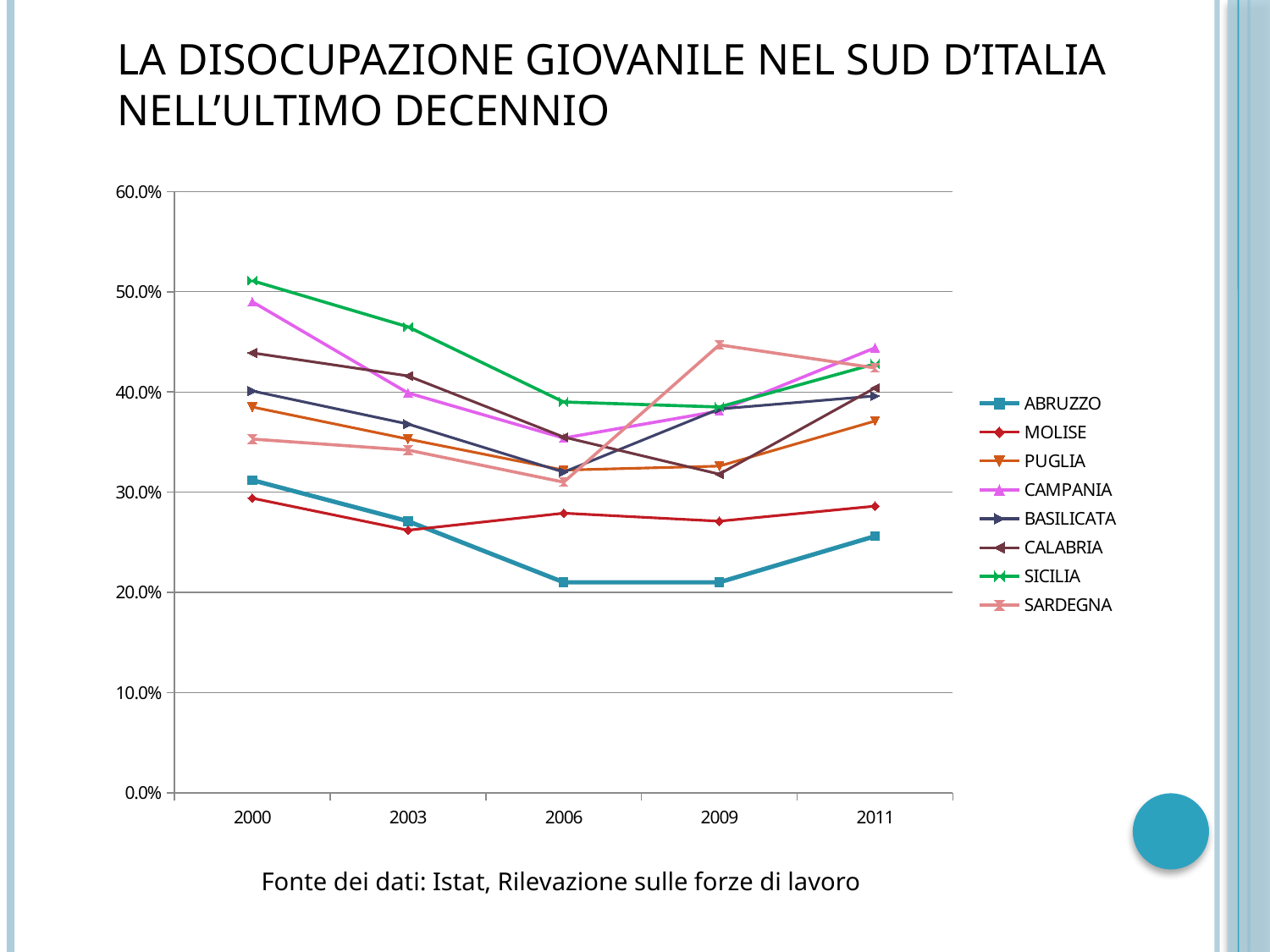
Which region has the lowest value in 2006? ABRUZZO What data source is cited below the chart? Istat, Rilevazione sulle forze di lavoro Is the value for CAMPANIA in 2011 greater or less than 40.0%? greater Which is larger in 2011, the value for SICILIA or the value for ABRUZZO? SICILIA Which region has the highest value in 2000? SICILIA Does the value for ABRUZZO rise or fall from 2000 to 2006? fall Which region has the highest value in 2009? SARDEGNA How many years are plotted along the x axis? 5 Is the value for ABRUZZO in 2006 greater or less than 30.0%? less What kind of chart is shown on the slide? line chart How many series does the legend list? 8 Is the value for MOLISE in 2009 greater or less than 30.0%? less